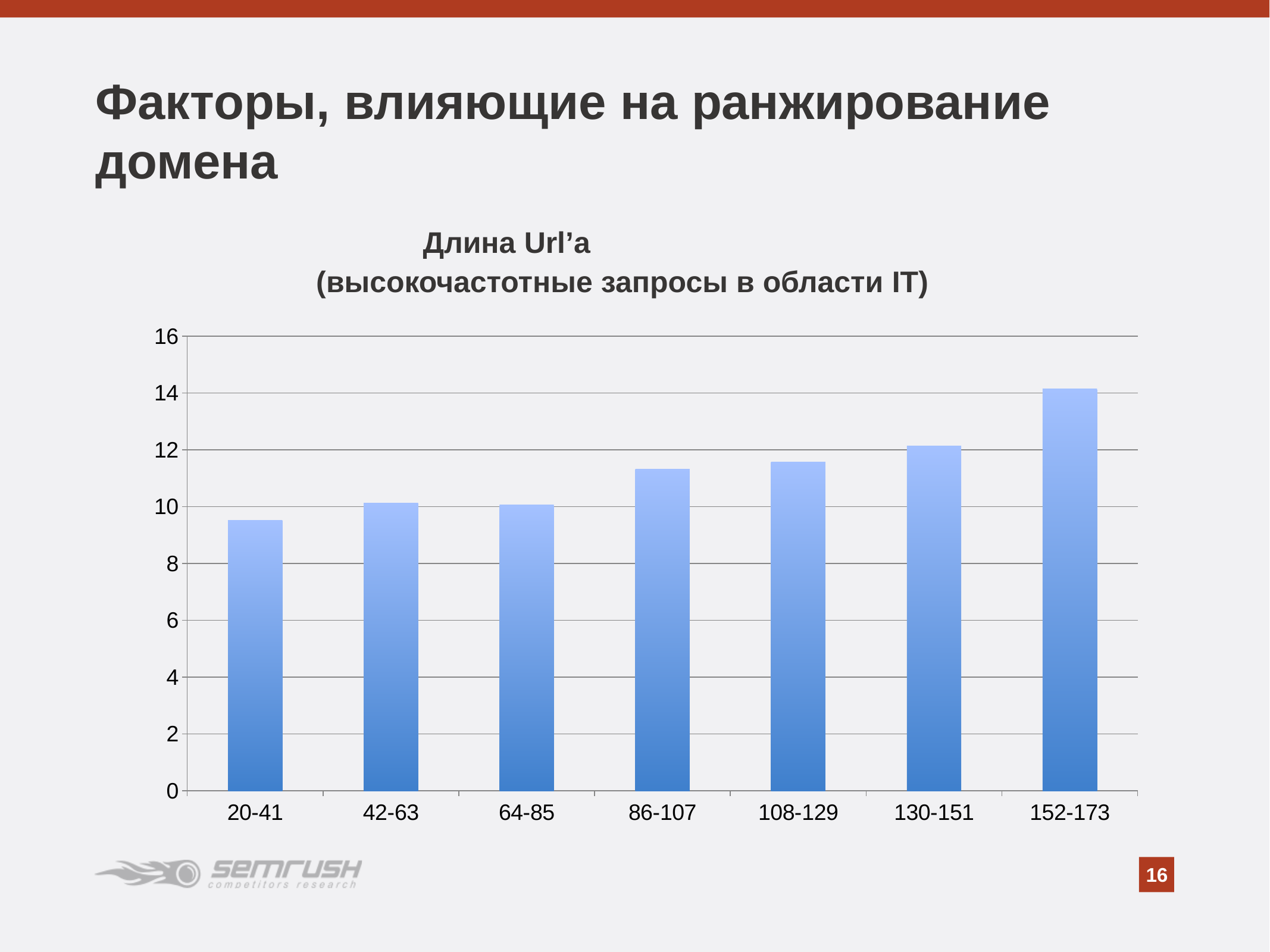
Is the value for 20-41 greater or less than 10? less Is the value for 108-129 greater or less than 12? less Which URL length category has the highest value? 152-173 Do the values generally rise or fall as URL length increases along the x axis? rise What is the title of the chart? Длина Url'а (высокочастотные запросы в области IT) Which is larger, the value for 86-107 or the value for 130-151? 130-151 Which URL length category has the lowest value? 20-41 Is the value for 152-173 greater or less than 12? greater How many URL length categories are shown on the x axis? 7 What kind of chart is shown on the slide? bar chart Which is larger, the value for 20-41 or the value for 152-173? 152-173